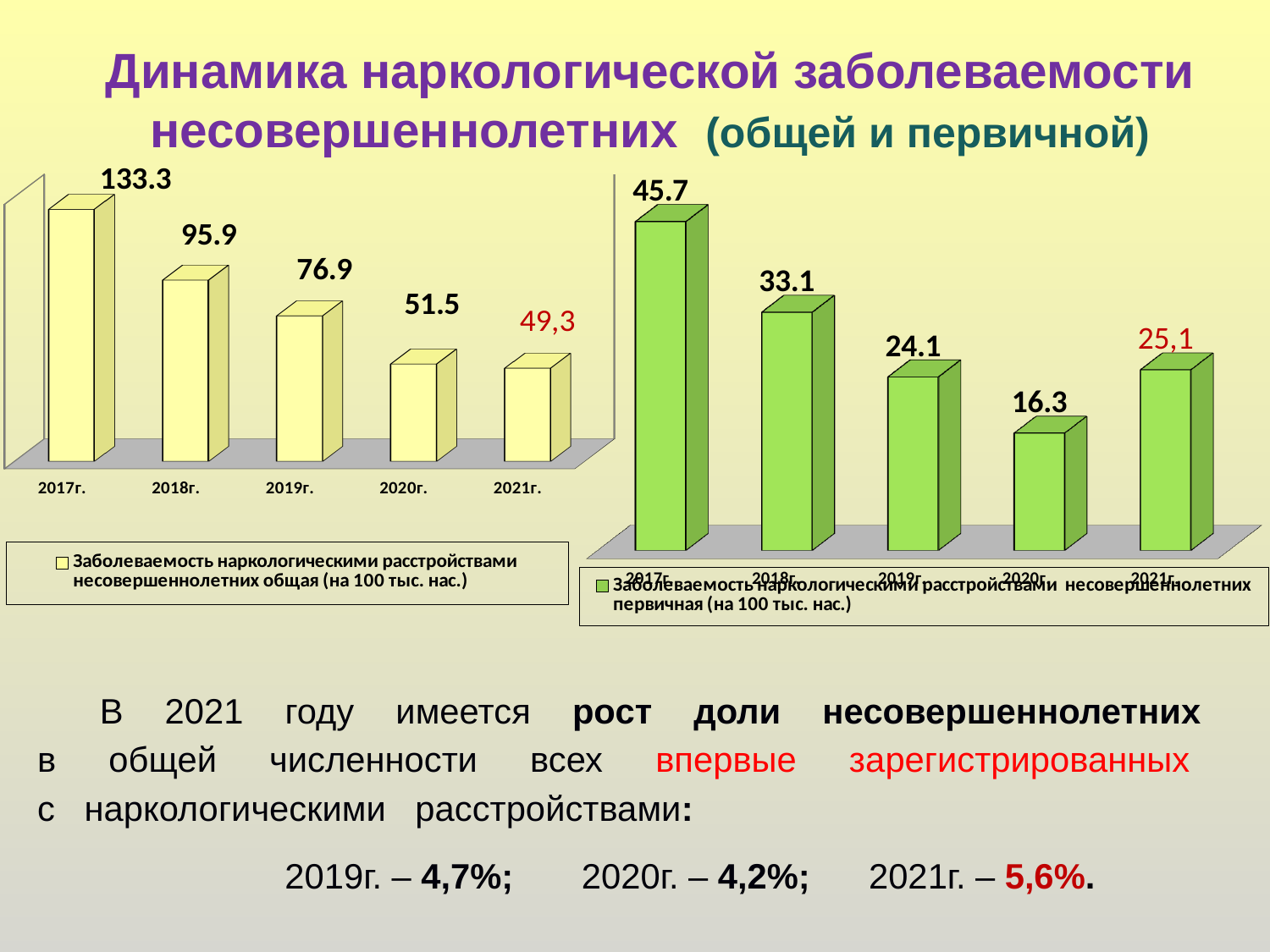
What type of chart is the right chart (primary incidence)? Bar chart In the left chart (general incidence), what is the difference between the values for 2017г. and 2018г.? 37.4 In the right chart (primary incidence), which is larger: the value for 2020г. or the value for 2021г.? 2021г. In the left chart (general incidence), do the values rise or fall from 2017г. to 2021г.? Fall In the right chart (primary incidence), what is the difference between the values for 2017г. and 2019г.? 21.6 How many years are shown in the left chart (general incidence)? 5 In the right chart (primary incidence), which year has the lowest value? 2020г. In the right chart (primary incidence), what is the value for 2021г.? 25,1 In the left chart (general incidence), what is the value for 2021г.? 49,3 In the left chart (general incidence), which year has the highest value? 2017г. In the right chart (primary incidence), what is the value for 2020г.? 16.3 In the left chart (general incidence), what is the value for 2017г.? 133.3